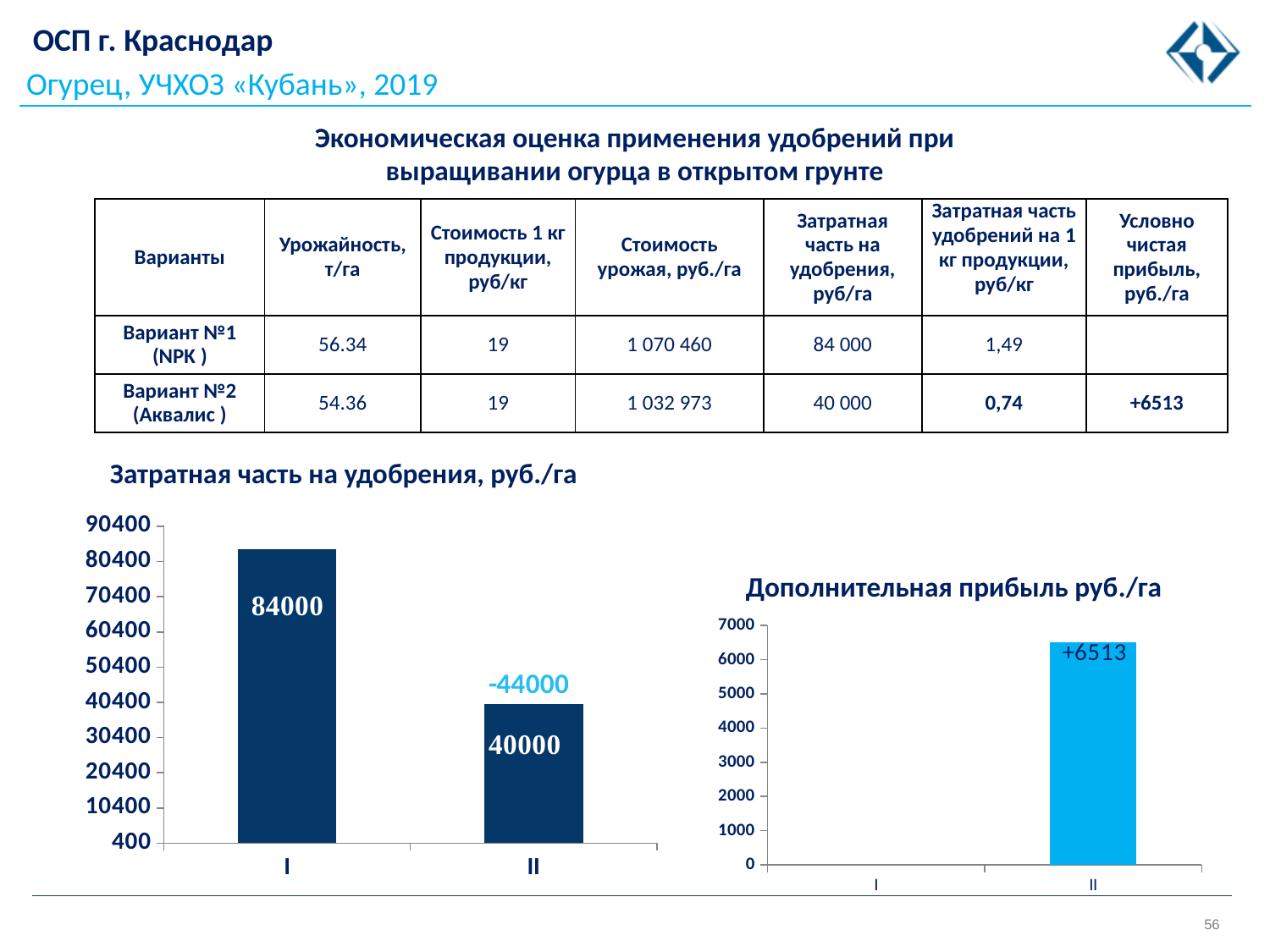
In the chart titled "Затратная часть на удобрения, руб./га", which category has the lowest value? II In the chart titled "Затратная часть на удобрения, руб./га", which category has the highest value? I In the chart titled "Затратная часть на удобрения, руб./га", what is the value for category I? 84000 In the chart titled "Затратная часть на удобрения, руб./га", how many categories are shown on the x axis? 2 In the chart titled "Затратная часть на удобрения, руб./га", what is the value for category II? 40000 In the chart titled "Затратная часть на удобрения, руб./га", what is the difference between the values for I and II? 44000 In the chart titled "Дополнительная прибыль руб./га", which category has the higher value, I or II? II What is the title of the chart on the right side of the slide? Дополнительная прибыль руб./га In the chart titled "Дополнительная прибыль руб./га", what is the value labelled for category II? +6513 In the chart titled "Дополнительная прибыль руб./га", is the value for II greater or less than 6000? greater What kind of chart is the one titled "Затратная часть на удобрения, руб./га"? bar chart In the chart titled "Затратная часть на удобрения, руб./га", do the values rise or fall from I to II? fall